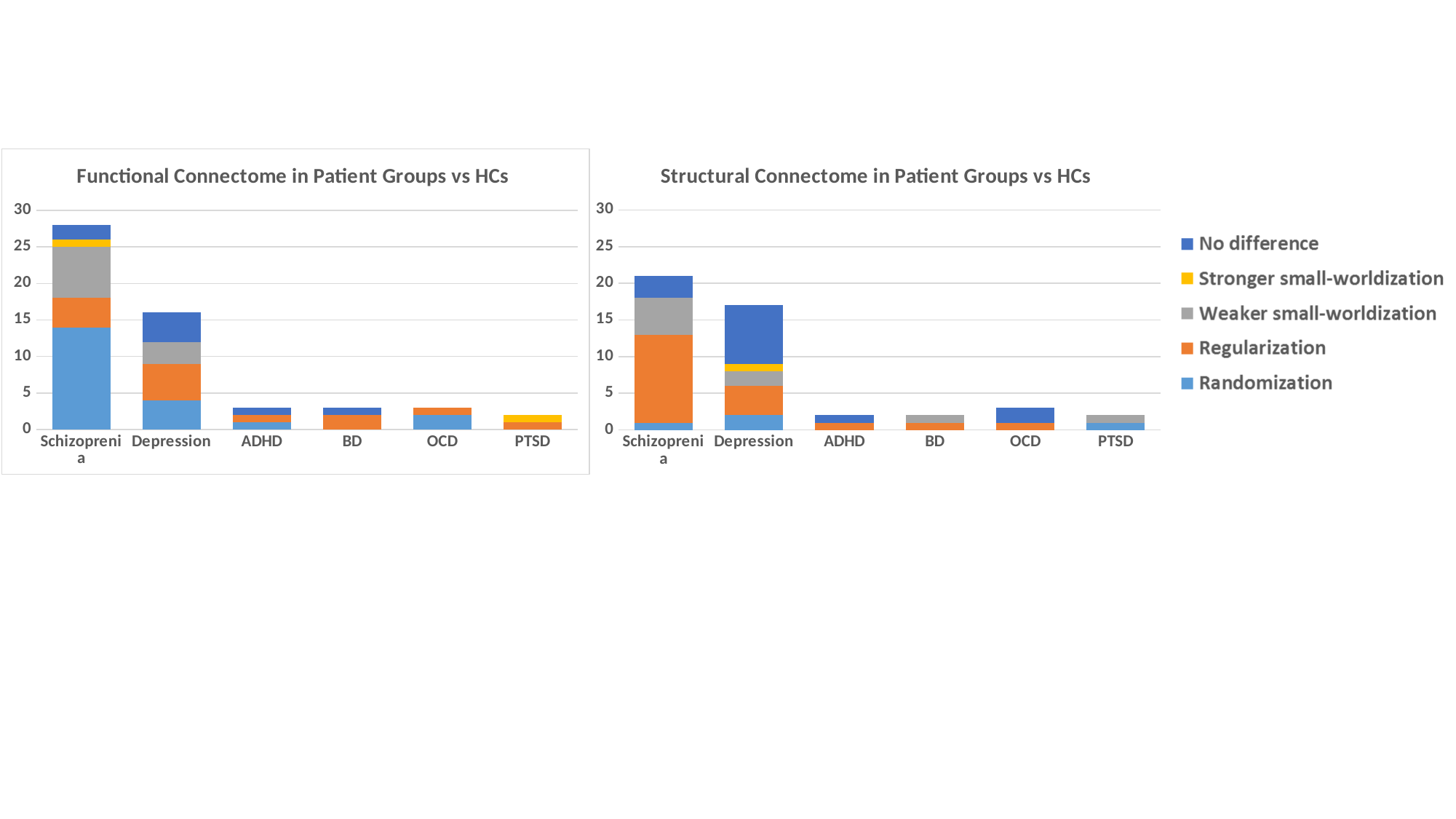
What colour represents the 'Regularization' series in the legend? Orange In the 'Functional Connectome in Patient Groups vs HCs' chart, is the total bar height for Depression greater or less than 10? greater In the 'Functional Connectome in Patient Groups vs HCs' chart, which patient group has the tallest stacked bar? Schizoprenia In the 'Structural Connectome in Patient Groups vs HCs' chart, which patient group has the tallest stacked bar? Schizoprenia Is the total stacked bar for Schizoprenia taller in the 'Functional Connectome' chart or the 'Structural Connectome' chart? Functional Connectome How many series does the legend list for the charts? 5 How many patient group categories are shown on the x axis of the 'Structural Connectome in Patient Groups vs HCs' chart? 6 What type of chart is the 'Functional Connectome in Patient Groups vs HCs' chart? Stacked bar chart In the 'Functional Connectome in Patient Groups vs HCs' chart, is the total bar height for Schizoprenia greater or less than 25? greater In the 'Functional Connectome in Patient Groups vs HCs' chart, which patient group has the shortest stacked bar? PTSD In the 'Structural Connectome in Patient Groups vs HCs' chart, is the total bar height for Schizoprenia greater or less than 25? less In the 'Structural Connectome in Patient Groups vs HCs' chart, which has the taller stacked bar, Schizoprenia or Depression? Schizoprenia